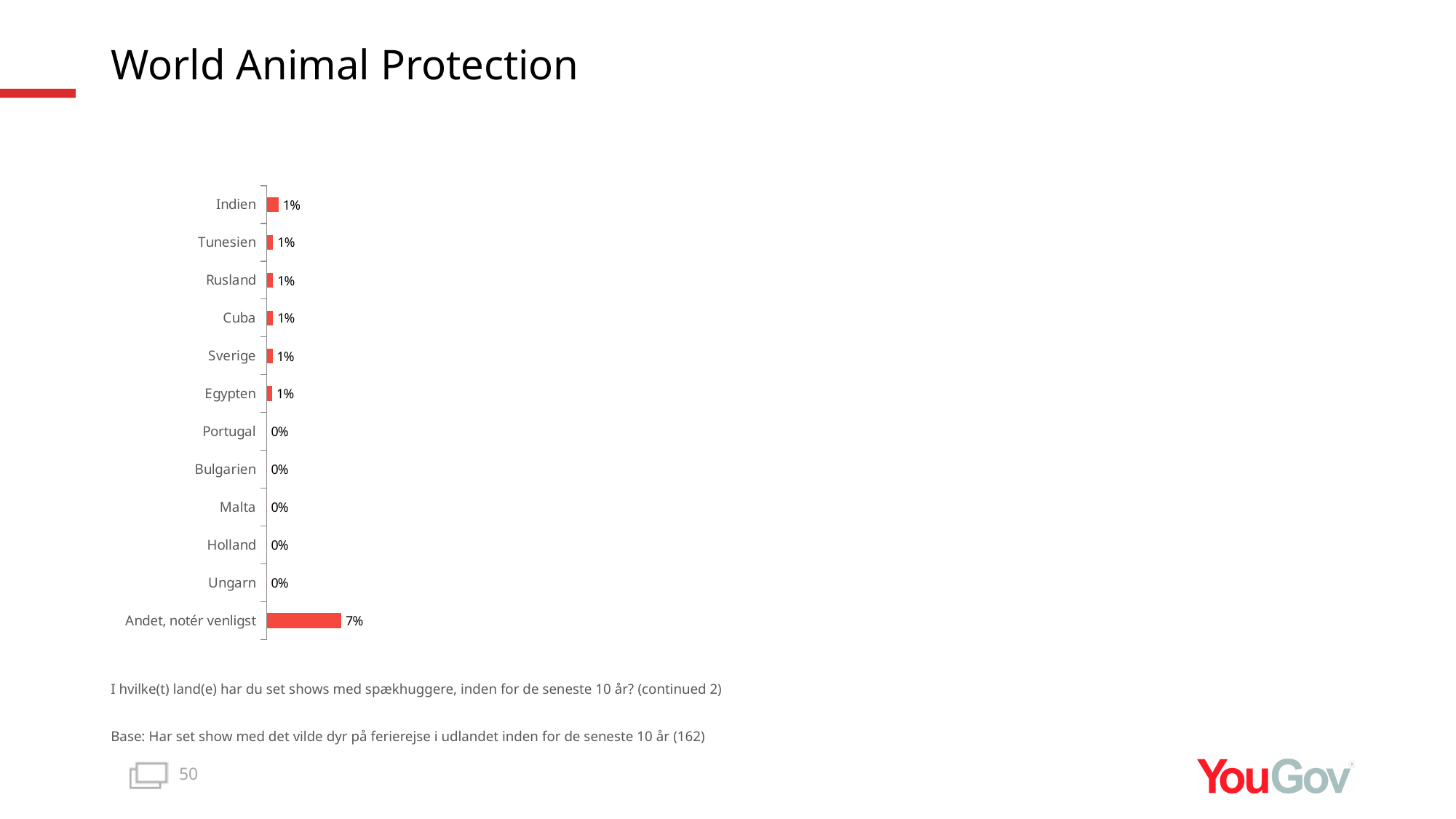
What is the value for Portugal? 0% What kind of chart is shown on the slide? Bar chart Which category has the highest value? Andet, notér venligst How many categories have a value of 0%? 5 Which is larger, the value for Cuba or the value for Malta? Cuba What is the value for Egypten? 1% What is the value for Ungarn? 0% What is the value for Andet, notér venligst? 7% What is the value for Indien? 1% What colour are the bars in the chart? Red How many categories are shown in the chart? 12 What is the difference between the values for Andet, notér venligst and Sverige? 6%